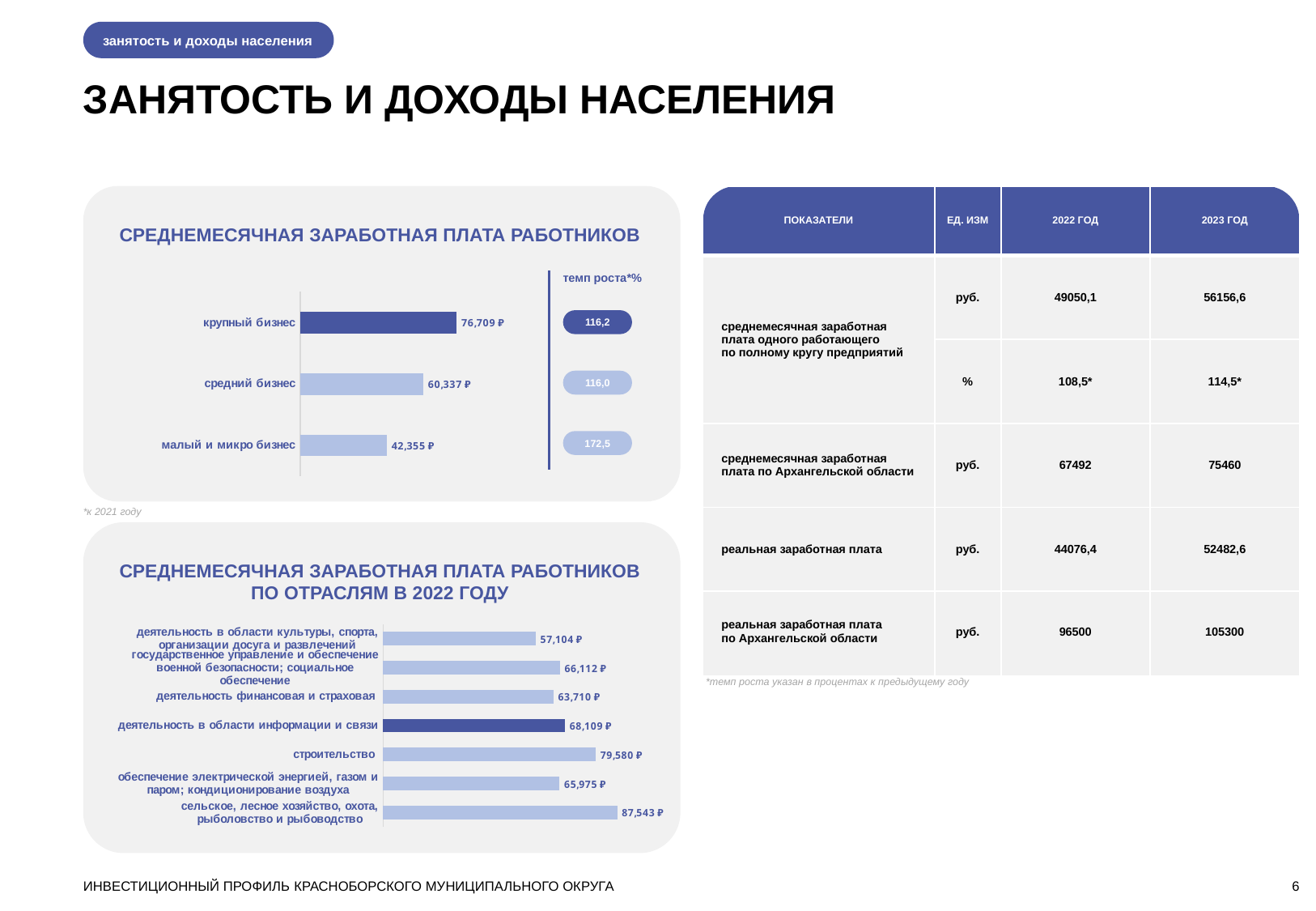
On the chart 'Среднемесячная заработная плата работников', which category has the lowest value? малый и микро бизнес On the chart 'Среднемесячная заработная плата работников по отраслям в 2022 году', what is the value for строительство? 79,580 ₽ What type of chart is 'Среднемесячная заработная плата работников по отраслям в 2022 году'? bar chart On the chart 'Среднемесячная заработная плата работников по отраслям в 2022 году', how many categories are plotted? 7 On the chart 'Среднемесячная заработная плата работников по отраслям в 2022 году', which is larger: деятельность в области информации и связи or деятельность финансовая и страховая? деятельность в области информации и связи On the chart 'Среднемесячная заработная плата работников по отраслям в 2022 году', which category has the highest value? сельское, лесное хозяйство, охота, рыболовство и рыбоводство On the chart 'Среднемесячная заработная плата работников', what is the difference between крупный бизнес and средний бизнес? 16,372 ₽ On the chart 'Среднемесячная заработная плата работников', what is the value for крупный бизнес? 76,709 ₽ On the chart 'Среднемесячная заработная плата работников', how many categories are plotted? 3 On the chart 'Среднемесячная заработная плата работников', what темп роста is shown for малый и микро бизнес? 172,5 On the chart 'Среднемесячная заработная плата работников', what is the value for малый и микро бизнес? 42,355 ₽ On the chart 'Среднемесячная заработная плата работников по отраслям в 2022 году', which category has the lowest value? деятельность в области культуры, спорта, организации досуга и развлечений